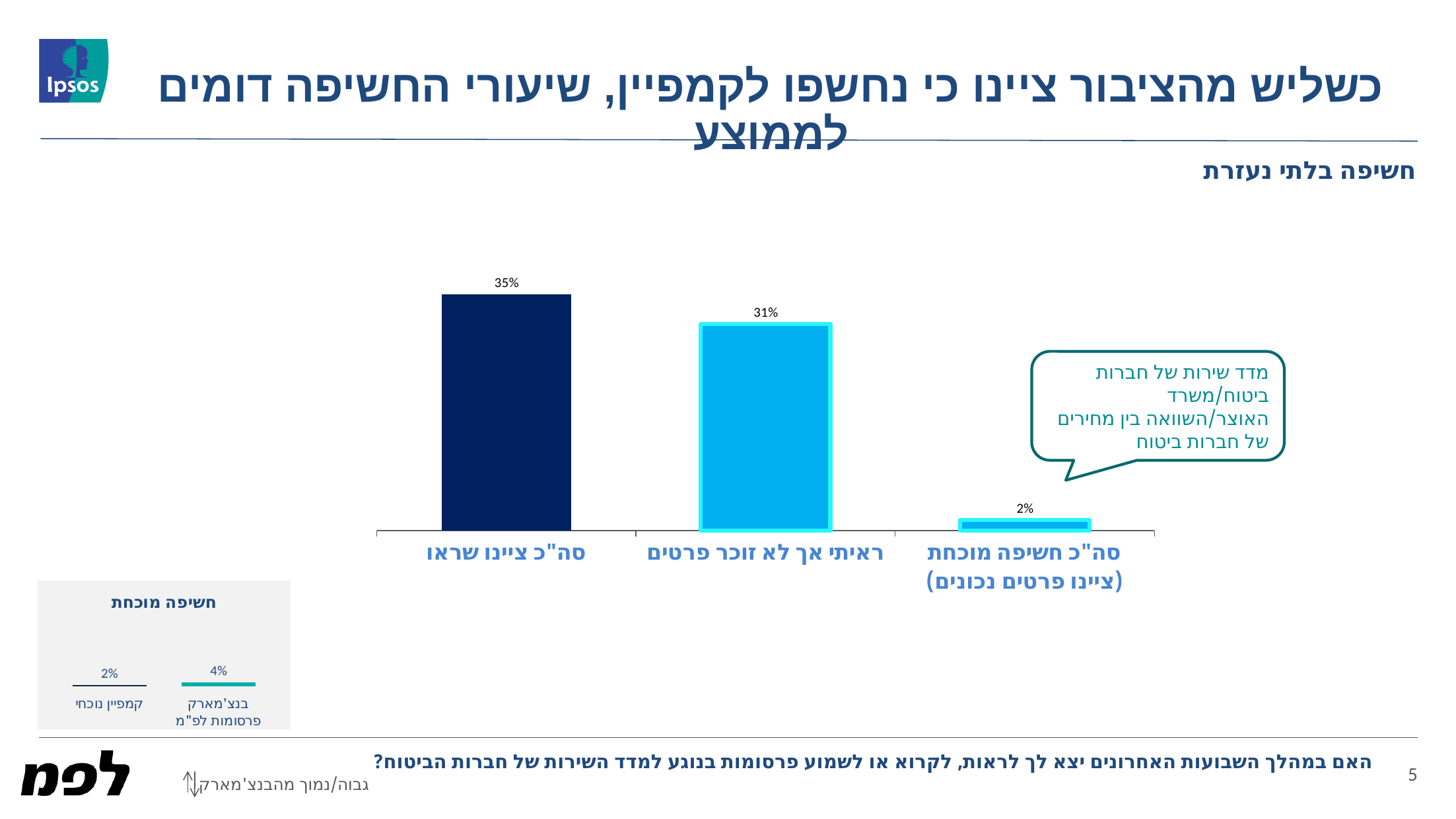
How many categories are shown in the main bar chart? 3 In the small "חשיפה מוכחת" chart at the bottom left, what is the difference between "בנצ'מארק פרסומות לפ"מ" and "קמפיין נוכחי"? 2% In the main bar chart, which category has the highest value? סה"כ ציינו שראו In the main bar chart, which category has the lowest value? סה"כ חשיפה מוכחת (ציינו פרטים נכונים) In the small "חשיפה מוכחת" chart at the bottom left, what is the value for "בנצ'מארק פרסומות לפ"מ"? 4% In the main bar chart, what is the value for "סה"כ ציינו שראו"? 35% In the main bar chart, what is the value for "ראיתי אך לא זוכר פרטים"? 31% In the main bar chart, what is the difference between "ראיתי אך לא זוכר פרטים" and "סה"כ חשיפה מוכחת (ציינו פרטים נכונים)"? 29% What type of chart is the main chart on the slide? Bar chart In the main bar chart, what is the value for "סה"כ חשיפה מוכחת (ציינו פרטים נכונים)"? 2% In the main bar chart, what is the difference between "סה"כ ציינו שראו" and "ראיתי אך לא זוכר פרטים"? 4% In the main bar chart, which is larger: "סה"כ ציינו שראו" or "ראיתי אך לא זוכר פרטים"? סה"כ ציינו שראו